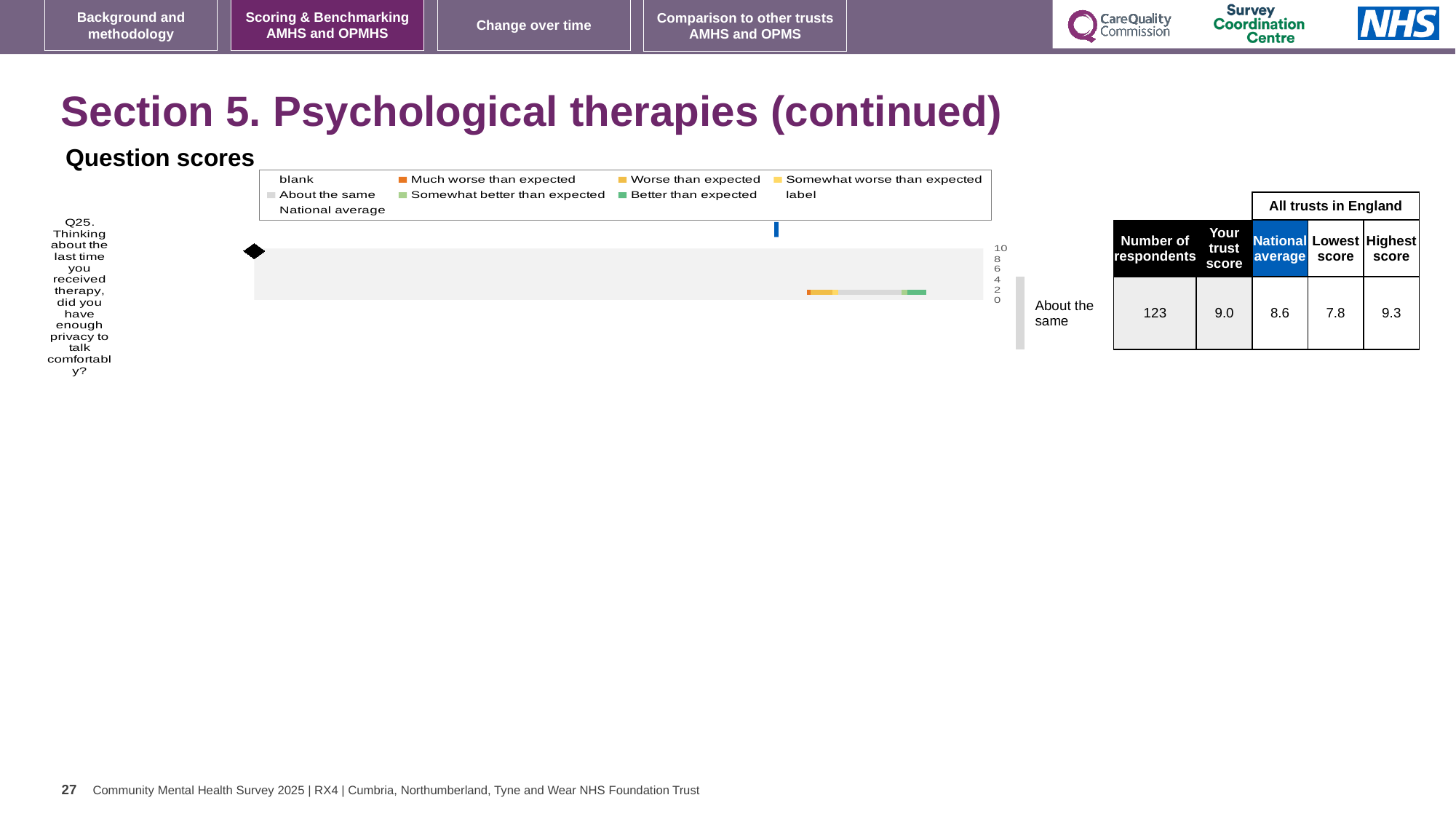
Which is larger for Q25, the trust's score or the national average? the trust's score What is the national average score for Q25? 8.6 What is the difference between the highest and lowest trust scores for Q25? 1.5 Which question is plotted in the chart? Q25. Thinking about the last time you received therapy, did you have enough privacy to talk comfortably? What is the trust's score for Q25? 9.0 What is the highest value shown on the chart's score axis? 10 How many survey questions are plotted in the chart? 1 What kind of chart is shown under 'Question scores'? bar chart What is the lowest score among all trusts in England for Q25? 7.8 How many respondents answered Q25? 123 How is the trust's Q25 score categorised relative to expectation? About the same What is the highest score among all trusts in England for Q25? 9.3